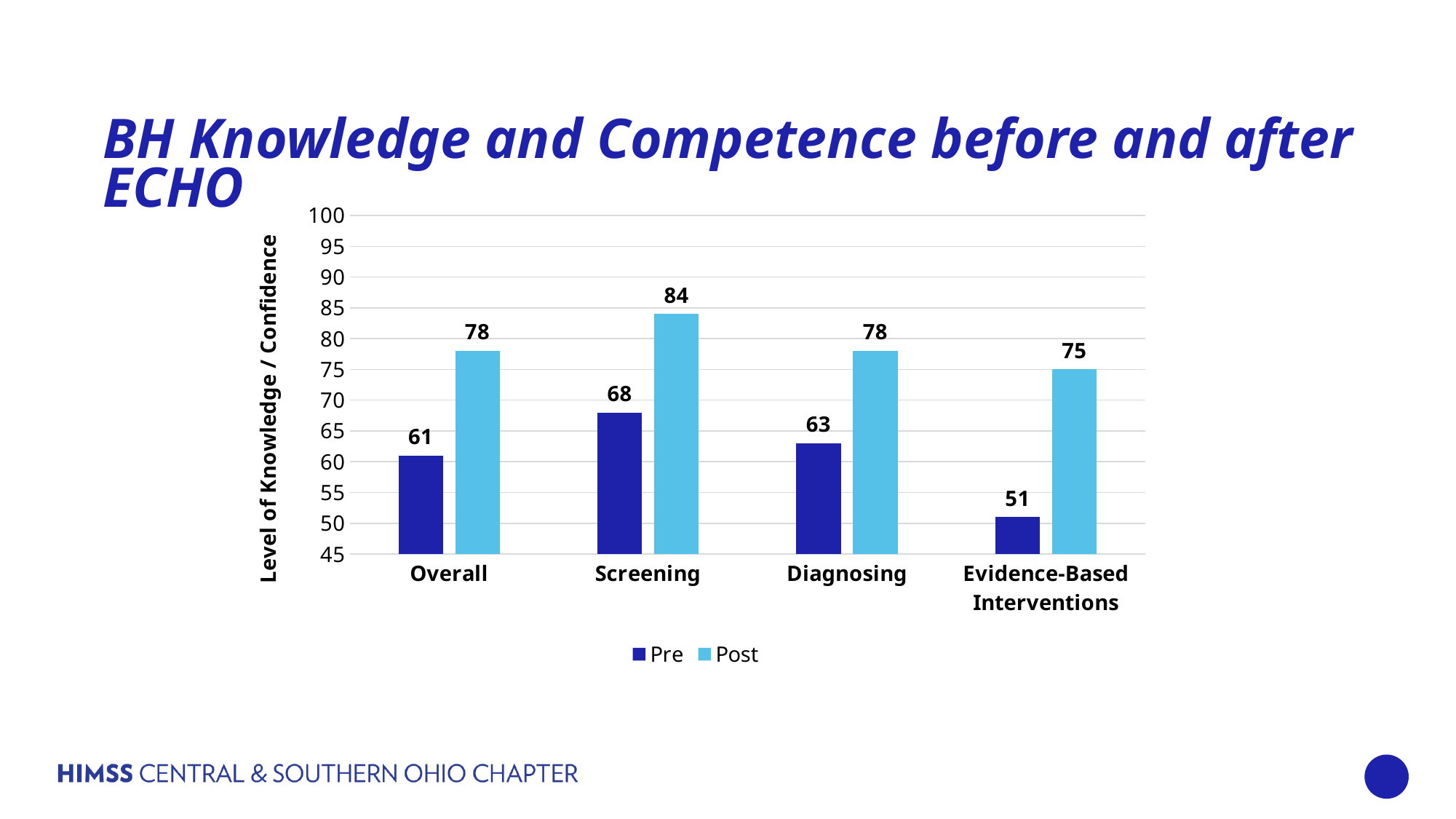
What is the Post value for Evidence-Based Interventions? 75 What is the Pre value for Screening? 68 Which category has the lowest Pre value? Evidence-Based Interventions What is the difference between the Post values for Screening and Diagnosing? 6 Which category has the highest Post value? Screening What kind of chart is shown on the slide? Bar chart How many categories are shown on the x axis? 4 What is the Pre value for Overall? 61 What is the difference between the Post and Pre values for Evidence-Based Interventions? 24 What is the label of the vertical axis? Level of Knowledge / Confidence Which is larger, the Pre value for Diagnosing or the Pre value for Screening? Screening How many series does the legend list? 2